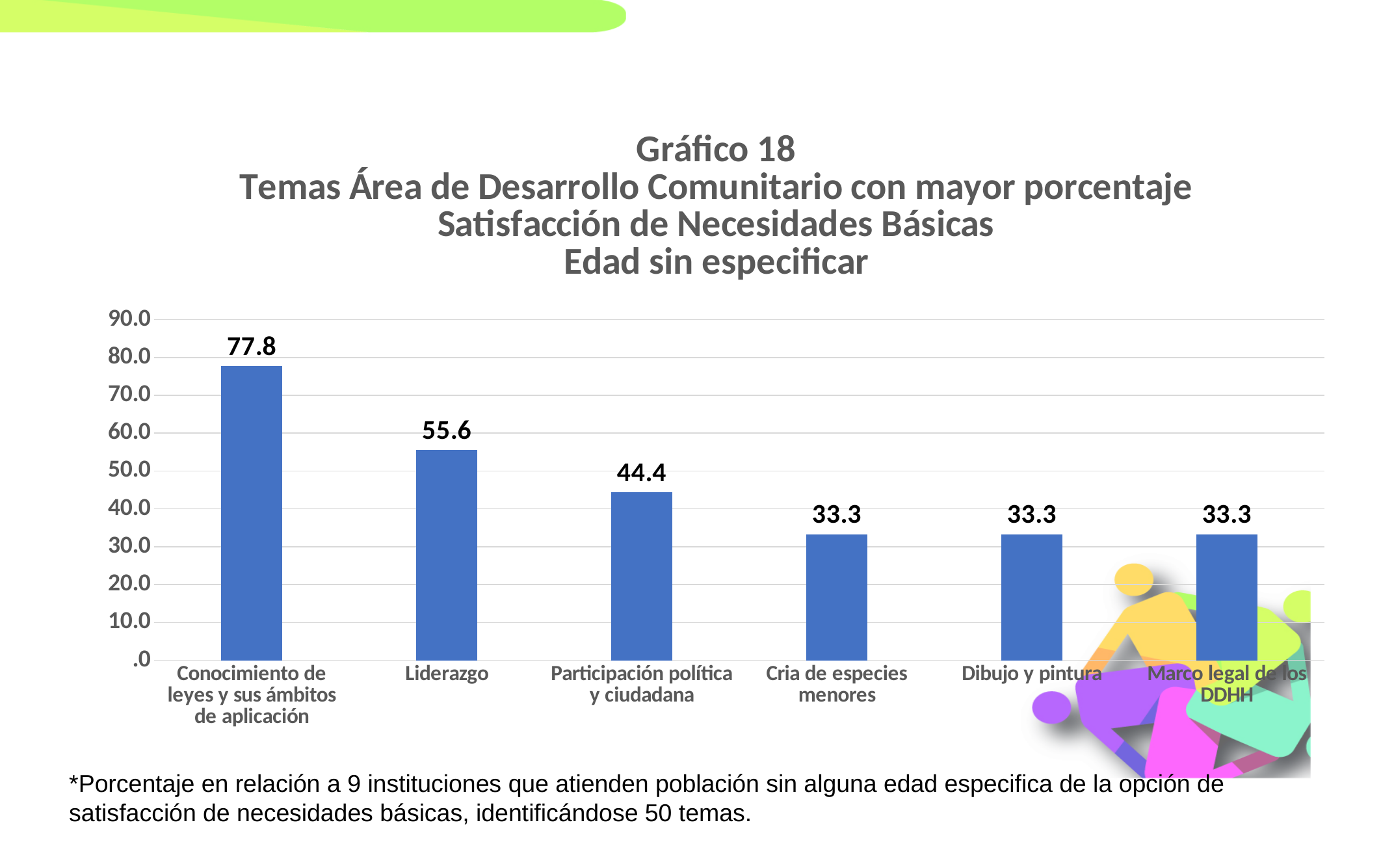
What is the difference between the values for Liderazgo and Cria de especies menores? 22.3 What is the value for Participación política y ciudadana? 44.4 How many categories are shown on the x axis? 6 Which is larger, the value for Participación política y ciudadana or the value for Marco legal de los DDHH? Participación política y ciudadana What is the value for Dibujo y pintura? 33.3 What kind of chart is shown on the slide? bar chart Do the values rise or fall from left to right along the x axis? fall What is the difference between the values for Conocimiento de leyes y sus ámbitos de aplicación and Liderazgo? 22.2 Which category has the highest value? Conocimiento de leyes y sus ámbitos de aplicación Is the value for Participación política y ciudadana greater or less than 50.0? less What is the value for Liderazgo? 55.6 What is the value for Conocimiento de leyes y sus ámbitos de aplicación? 77.8